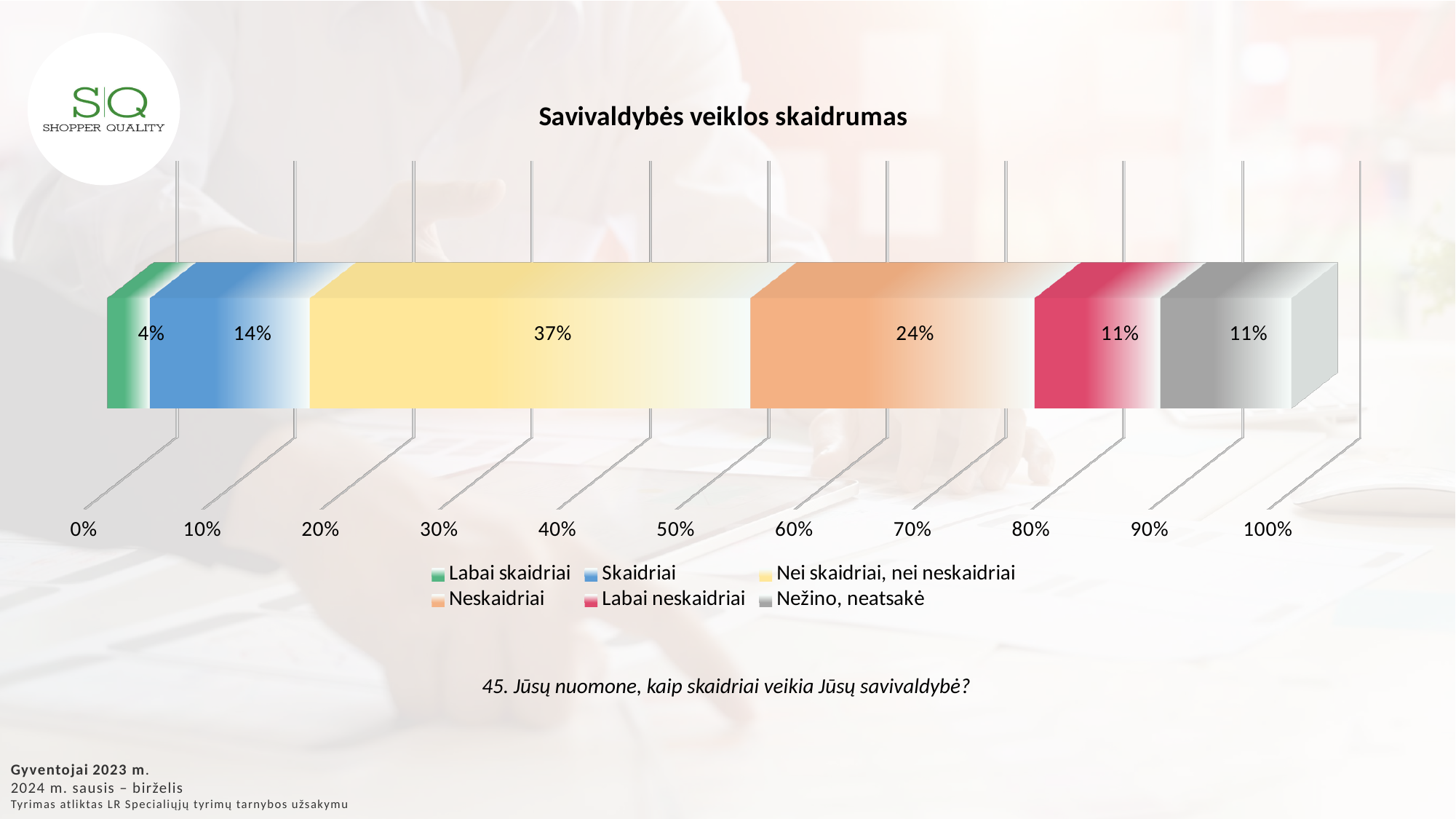
What kind of chart is shown? Stacked bar chart Which series has the highest value? Nei skaidriai, nei neskaidriai How many series does the legend list? 6 What is the difference between the values for 'Nei skaidriai, nei neskaidriai' and 'Neskaidriai'? 13% Which is larger, the value for 'Skaidriai' or the value for 'Labai neskaidriai'? Skaidriai What is the value for 'Neskaidriai'? 24% What is the total of the stacked bar? 101% Which series has the lowest value? Labai skaidriai What is the value for 'Nei skaidriai, nei neskaidriai'? 37% What is the value for 'Skaidriai'? 14% What is the value for 'Labai skaidriai'? 4% What is the title of the chart? Savivaldybės veiklos skaidrumas